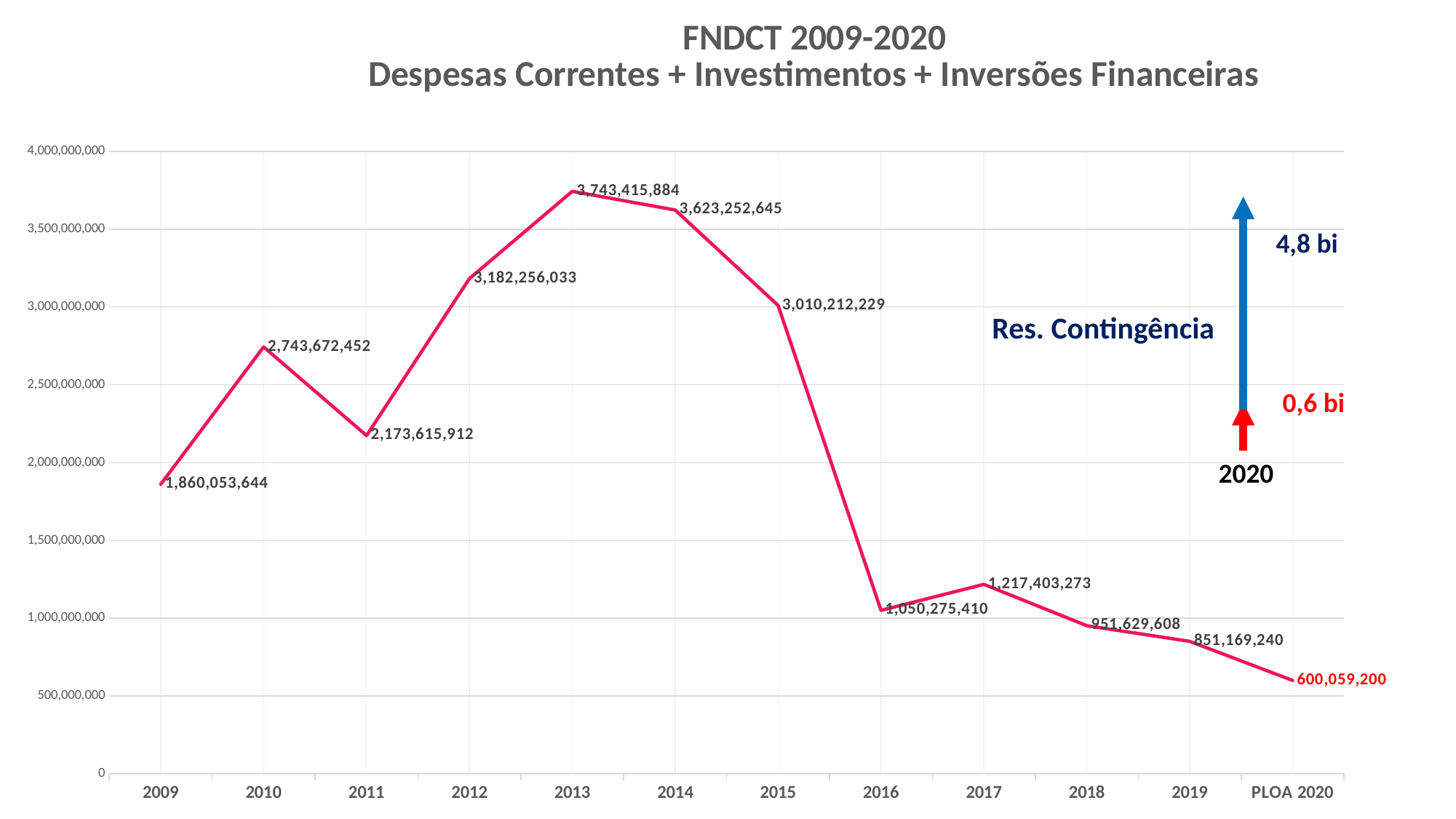
What is the value for 2009? 1,860,053,644 What is the difference between the values for 2013 and 2014? 120,163,239 What is the value for PLOA 2020? 600,059,200 How many data points are plotted on the line? 12 Which year has the highest value? 2013 What kind of chart is shown? Line chart Do the values rise or fall from 2017 to PLOA 2020? Fall Which is larger, the value for 2010 or the value for 2011? 2010 What is the value for 2013? 3,743,415,884 What is the value for 2016? 1,050,275,410 What is the difference between the values for 2019 and PLOA 2020? 251,110,040 Which category has the lowest value? PLOA 2020